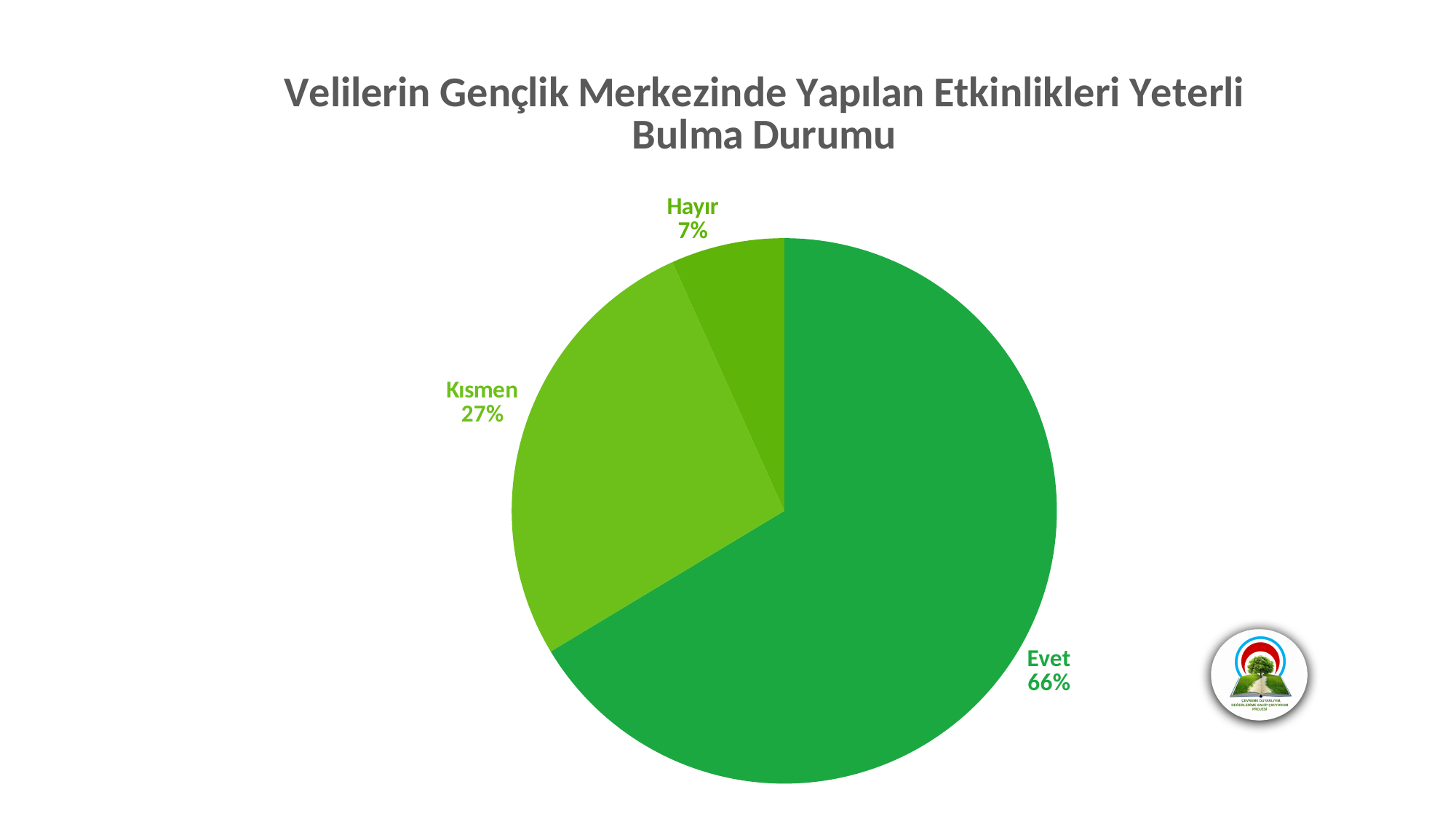
What percentage of the pie is the Hayır slice? 7% What is the difference in percentage points between the Kısmen and Hayır slices? 20 What is the difference in percentage points between the Evet and Kısmen slices? 39 What percentage of the pie is the Evet slice? 66% Which slice is larger, Kısmen or Hayır? Kısmen What percentage of the pie is the Kısmen slice? 27% What kind of chart is shown on the slide? pie chart Which slice is the largest? Evet What share of the pie do the Kısmen and Hayır slices make up together? 34% How many slices does the pie chart have? 3 Which slice is the smallest? Hayır What is the title of the chart? Velilerin Gençlik Merkezinde Yapılan Etkinlikleri Yeterli Bulma Durumu